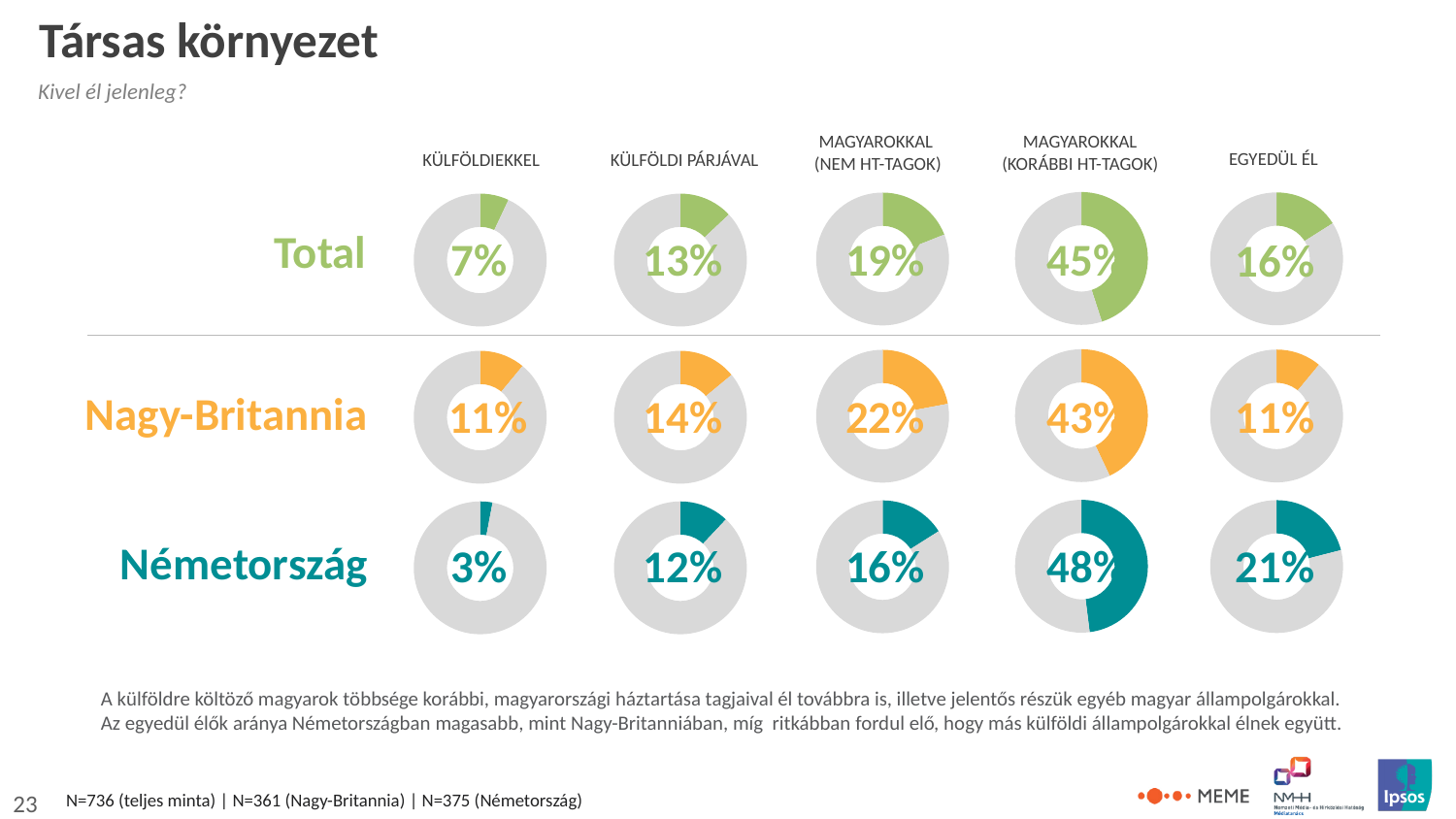
In the Németország row, which category has the lowest value? Külföldiekkel What is the difference between the Magyarokkal (korábbi HT-tagok) values for Németország and Nagy-Britannia? 5 percentage points In the Németország row, what is the value for Külföldi párjával? 12% What is the difference between the Egyedül él values for Németország and Nagy-Britannia? 10 percentage points In the Total row, which category has the highest value? Magyarokkal (korábbi HT-tagok) For Magyarokkal (nem HT-tagok), which is larger: the Nagy-Britannia value or the Németország value? Nagy-Britannia In the Nagy-Britannia row, what is the value for Külföldiekkel? 11% What colour are the donut segments in the Nagy-Britannia row? Orange In the Total row, what is the value for Magyarokkal (korábbi HT-tagok)? 45% How many category columns of donut charts are shown on the slide? 5 What kind of chart is used to show the values on this slide? Donut chart In the Németország row, what is the value for Egyedül él? 21%